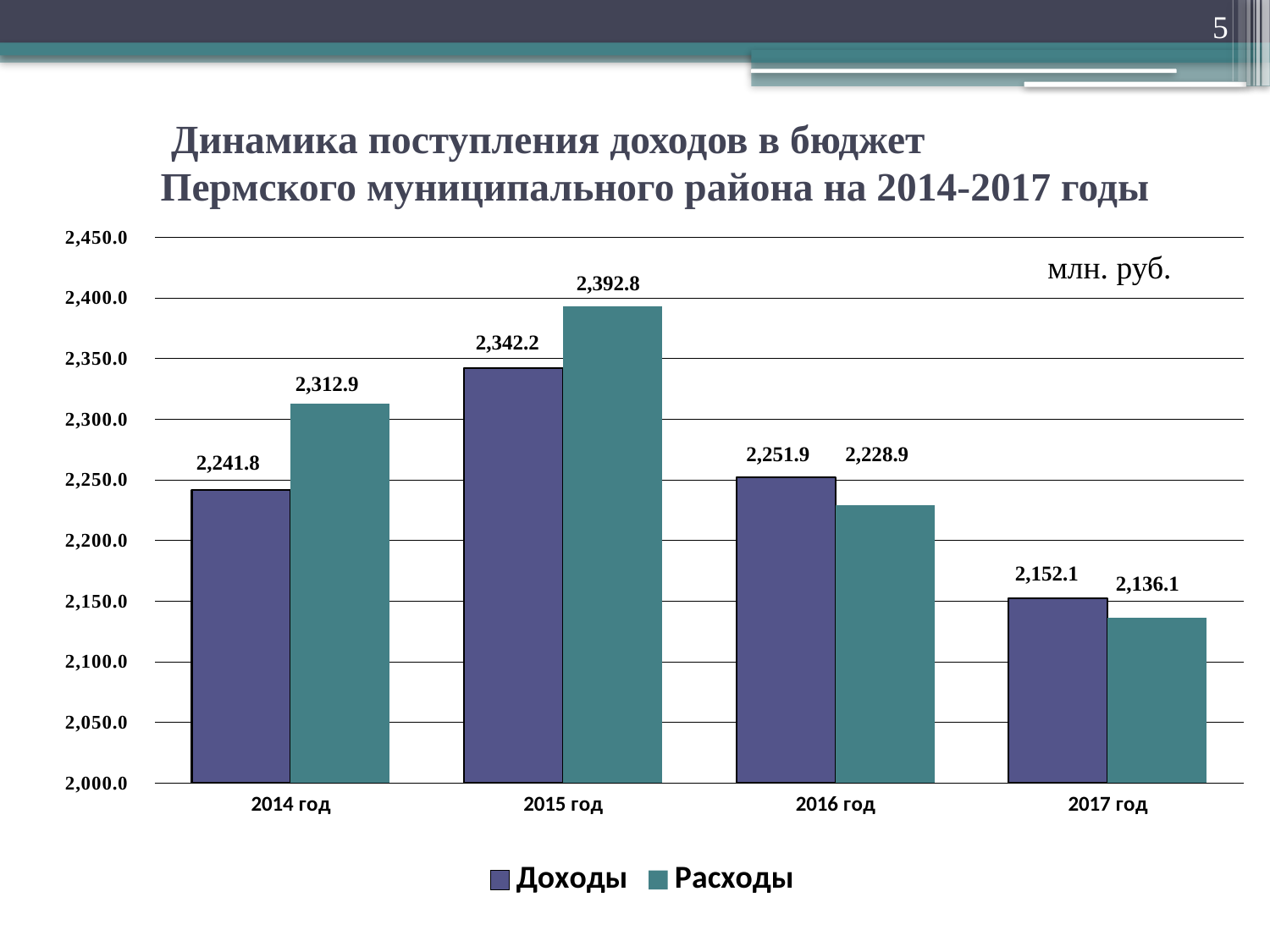
Which year has the lowest Доходы value? 2017 год What is the difference between Расходы and Доходы in 2015 год? 50.6 Which is larger in 2016 год, Доходы or Расходы? Доходы What is the value of Расходы for 2014 год? 2,312.9 Is the value of Доходы for 2014 год greater or less than 2,250.0? less How many series does the legend list? 2 What is the value of Расходы for 2017 год? 2,136.1 What is the value of Доходы for 2015 год? 2,342.2 What unit is indicated on the chart? млн. руб. How many years are shown on the x axis? 4 What kind of chart is shown on the slide? bar chart Which year has the highest Расходы value? 2015 год